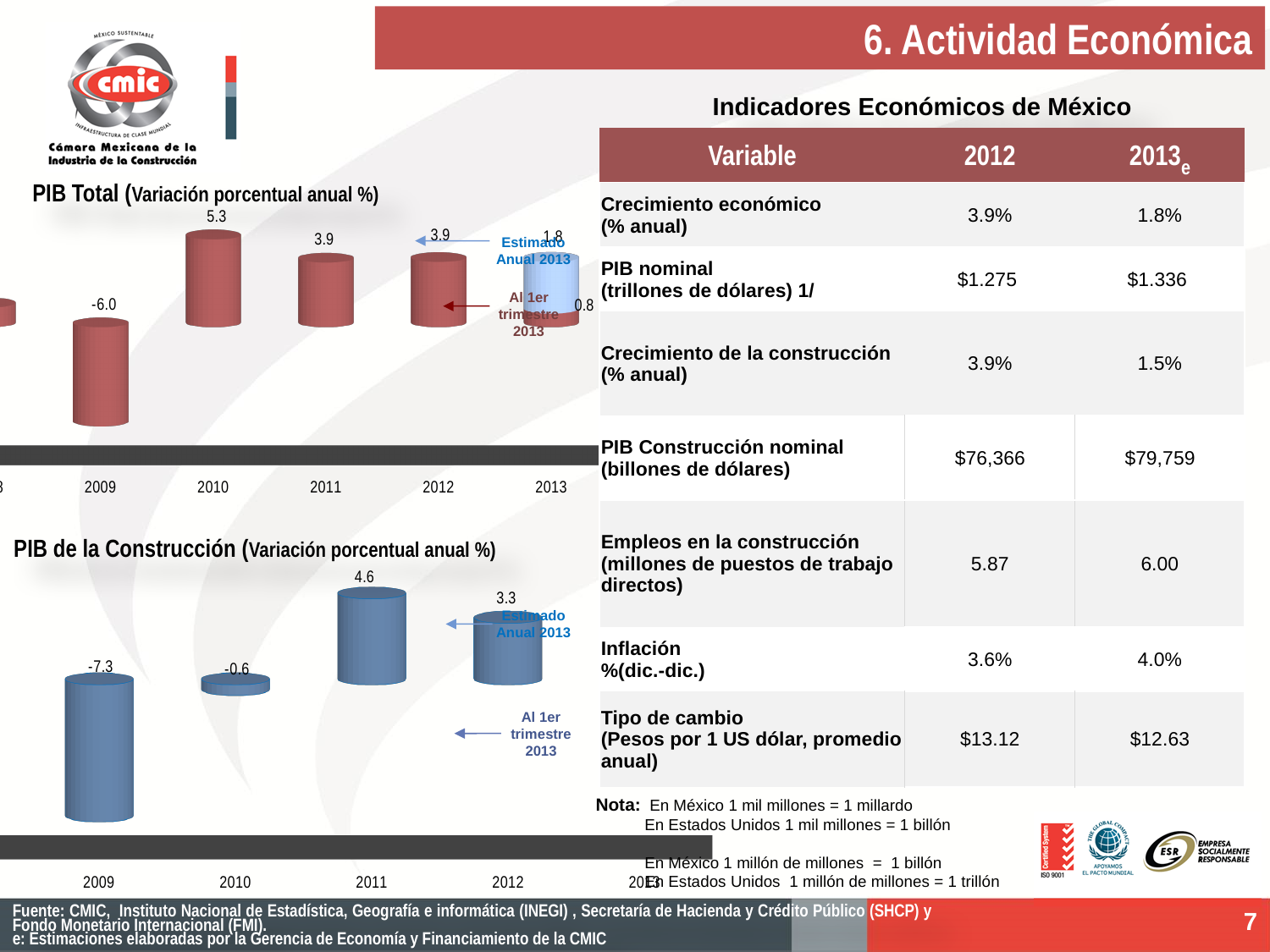
In the 'PIB Total' chart, which year from 2009 to 2013 has the highest value? 2010 In the 'PIB de la Construcción' chart, what is the difference between the 2011 value and the 2009 value? 11.9 In the 'PIB Total' chart, what is the difference between the 2010 value and the 2011 value? 1.4 In the 'PIB Total' chart, what is the value labeled 'Estimado Anual 2013'? 1.8 In the 'PIB Total' chart, what is the value for 2009? -6.0 In the 'PIB Total' chart, what is the value labeled 'Al 1er trimestre 2013'? 0.8 In the 'PIB de la Construcción' chart, which year has the lowest value? 2009 What kind of chart is the 'PIB Total (Variación porcentual anual %)' chart? bar chart In the 'PIB de la Construcción' chart, which is larger, the value for 2010 or the value for 2011? 2011 In the 'PIB de la Construcción' chart, what is the value for 2009? -7.3 In the 'PIB Total' chart, what is the value for 2010? 5.3 In the 'PIB de la Construcción' chart, what is the value for 2011? 4.6